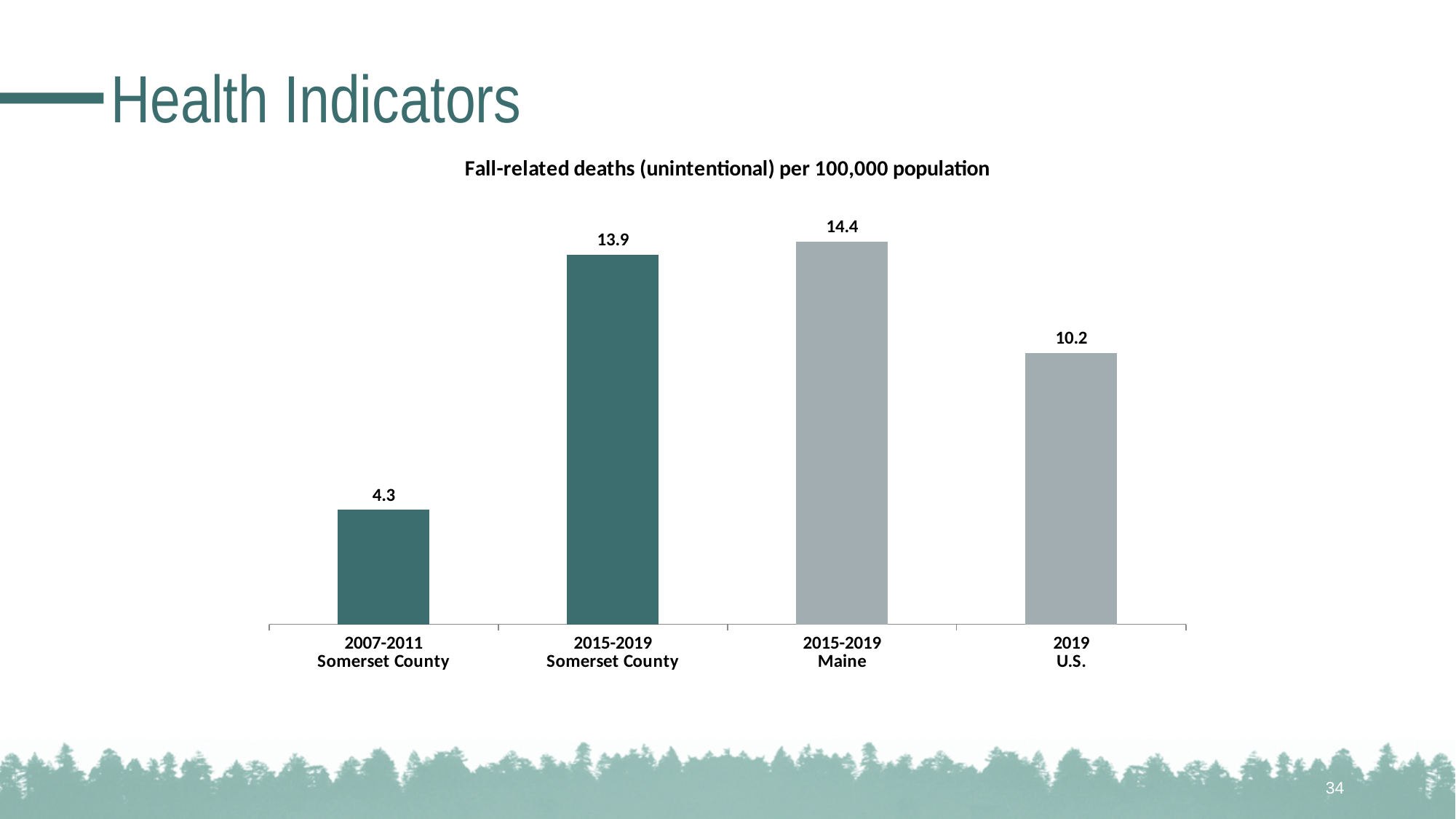
What is the title of the chart? Fall-related deaths (unintentional) per 100,000 population What is the difference between the 2015-2019 Somerset County value and the 2007-2011 Somerset County value? 9.6 Which is larger, the value for 2015-2019 Somerset County or the value for 2019 U.S.? 2015-2019 Somerset County What kind of chart is shown on the slide? Bar chart What is the value for 2007-2011 Somerset County? 4.3 What is the value for 2015-2019 Somerset County? 13.9 What is the value for 2015-2019 Maine? 14.4 What is the value for 2019 U.S.? 10.2 Which category has the lowest value? 2007-2011 Somerset County What is the difference between the 2015-2019 Maine value and the 2019 U.S. value? 4.2 Which category has the highest value? 2015-2019 Maine How many bars are shown in the chart? 4